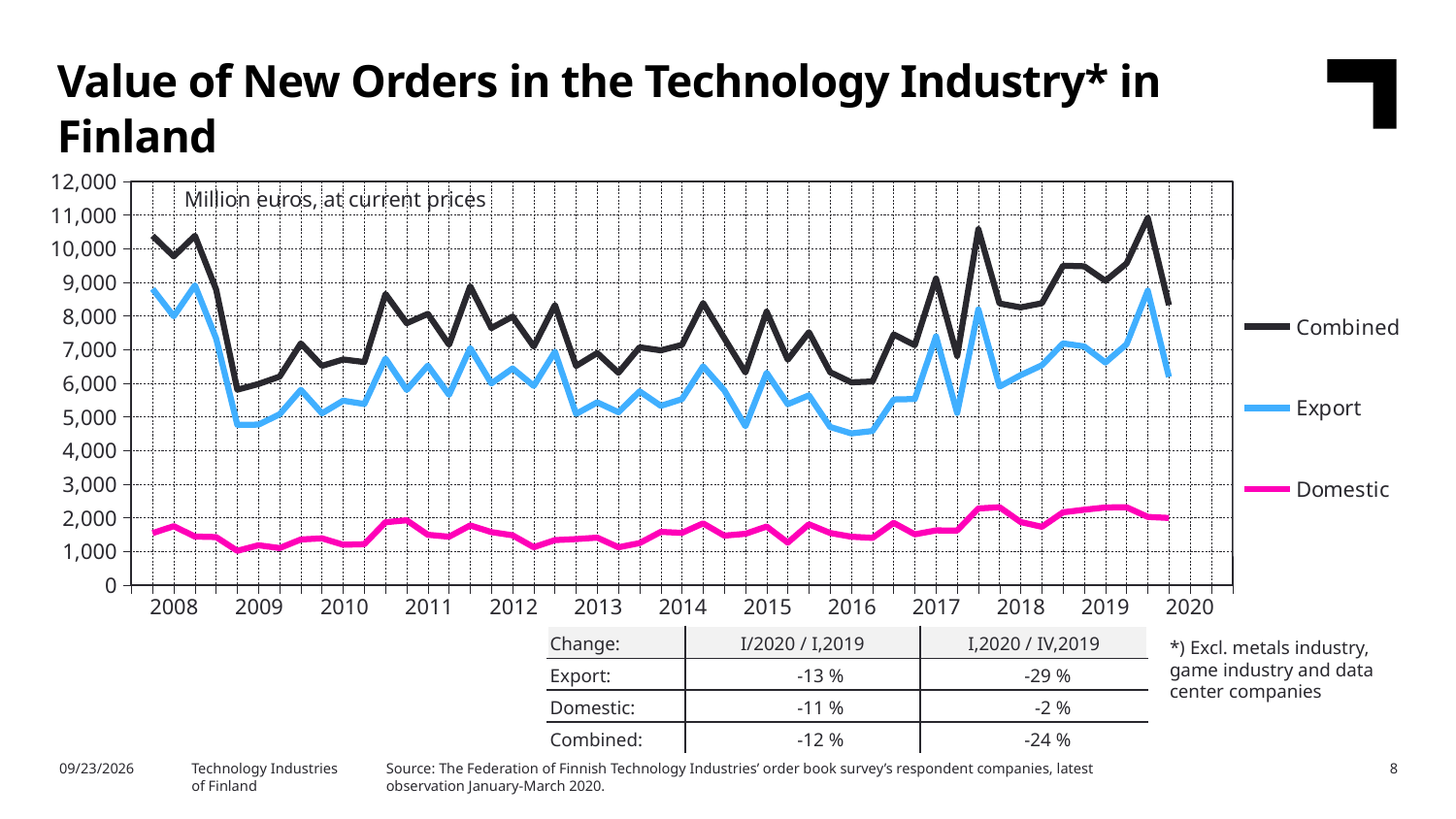
Which is larger at the 2020 point, Combined or Export? Combined Is the value for Combined at the first 2008 point greater or less than 10,000? greater What unit label is printed inside the plot area? Million euros, at current prices Does the Combined series rise or fall from its 2019 peak to the 2020 point? fall Is the value for Export at the 2020 point greater or less than 7,000? less What kind of chart is shown on the slide? line chart How many series does the legend list? 3 What are the three series named in the legend? Combined, Export, Domestic Which series has the lowest values throughout the chart? Domestic Which series has the highest values throughout the chart? Combined Is the value for Domestic at the 2020 point greater or less than 3,000? less How many year labels are shown on the x axis? 13